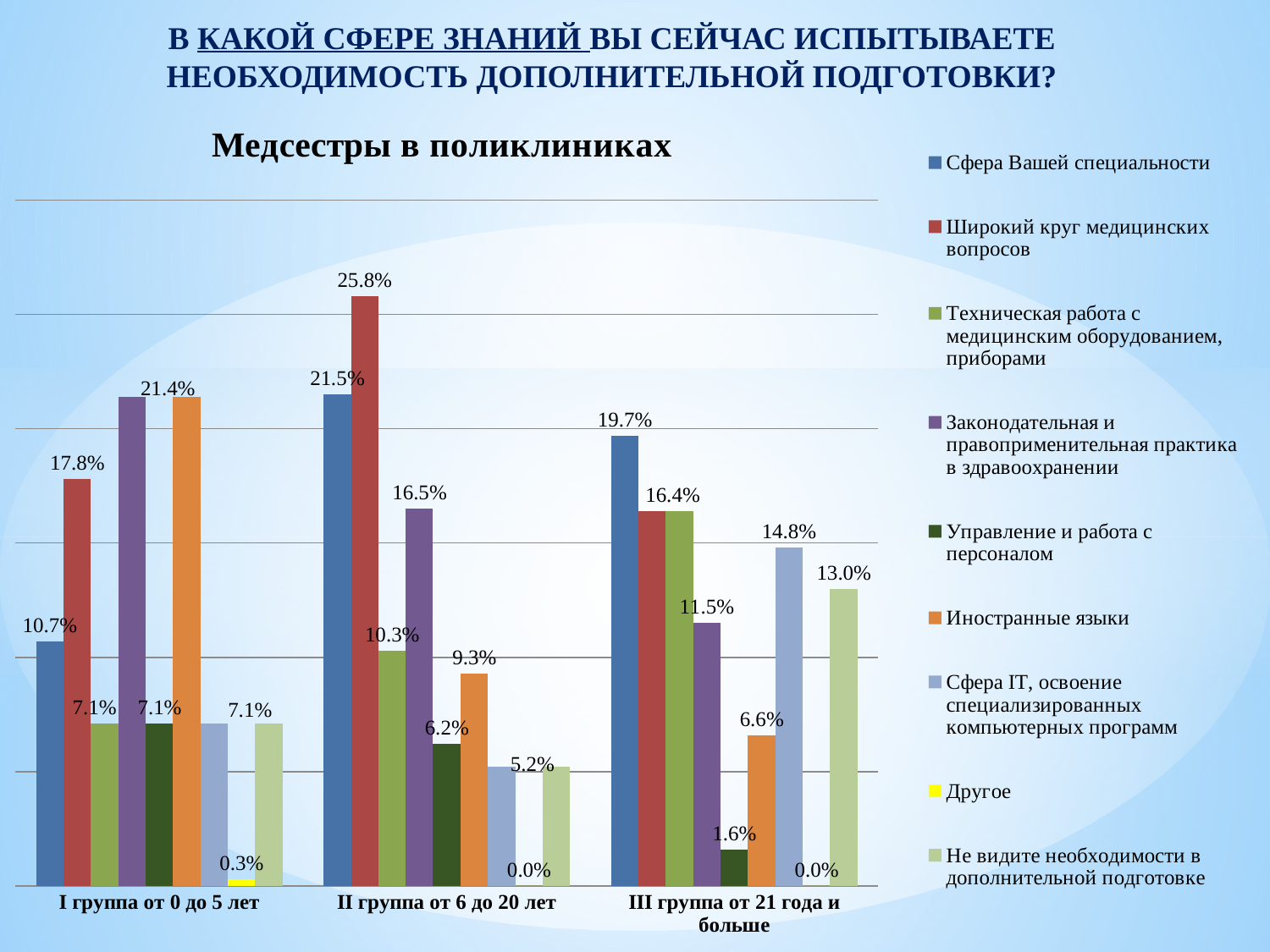
What is the value for «Сфера Вашей специальности» in «III группа от 21 года и больше»? 19.7% What is the value for «Управление и работа с персоналом» in «III группа от 21 года и больше»? 1.6% How many series does the legend list? 9 What is the difference between «Широкий круг медицинских вопросов» and «Сфера Вашей специальности» in «II группа от 6 до 20 лет»? 4.3% What is the value for «Широкий круг медицинских вопросов» in «II группа от 6 до 20 лет»? 25.8% How many groups (categories) are shown on the x axis? 3 In which group is the value for «Широкий круг медицинских вопросов» the highest? II группа от 6 до 20 лет Which is larger: «Сфера Вашей специальности» in «I группа от 0 до 5 лет» or in «II группа от 6 до 20 лет»? II группа от 6 до 20 лет What kind of chart is shown on the slide? Bar chart Which series has the highest value in «II группа от 6 до 20 лет»? Широкий круг медицинских вопросов What is the value for «Сфера IT, освоение специализированных компьютерных программ» in «III группа от 21 года и больше»? 14.8% What is the value for «Другое» in «I группа от 0 до 5 лет»? 0.3%